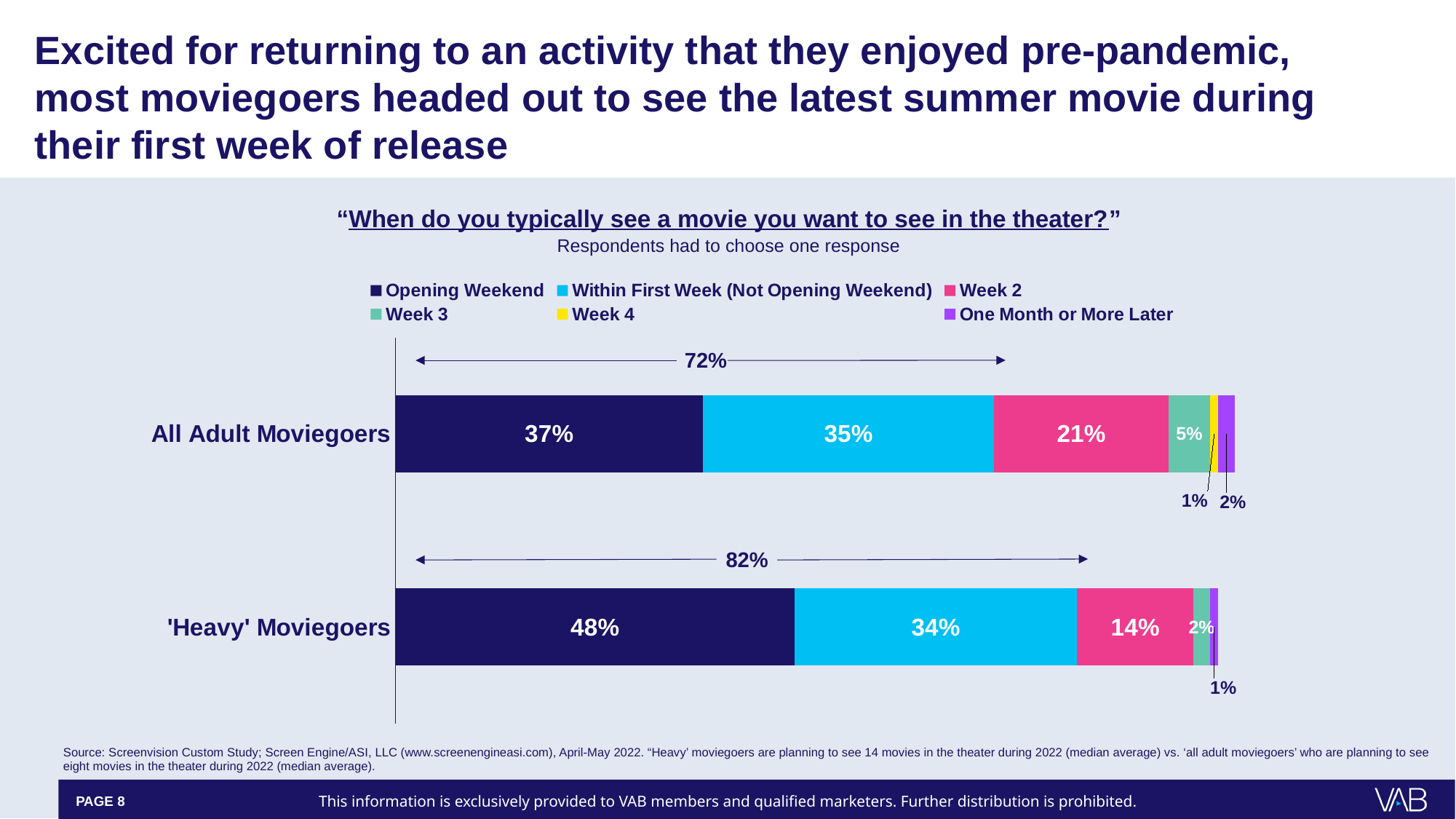
What is the Opening Weekend value for 'Heavy' Moviegoers? 48% What is the Within First Week (Not Opening Weekend) value for 'Heavy' Moviegoers? 34% Which response has the lowest share among All Adult Moviegoers? Week 4 What is the Opening Weekend value for All Adult Moviegoers? 37% Which group has the larger Week 2 value, All Adult Moviegoers or 'Heavy' Moviegoers? All Adult Moviegoers What is the Week 3 value for All Adult Moviegoers? 5% How many series does the legend list? 6 What kind of chart is shown on the slide? Stacked bar chart How many categories (respondent groups) are plotted in the chart? 2 What is the Week 2 value for 'Heavy' Moviegoers? 14% What is the difference between the Opening Weekend values for 'Heavy' Moviegoers and All Adult Moviegoers? 11% Which response has the highest share among All Adult Moviegoers? Opening Weekend